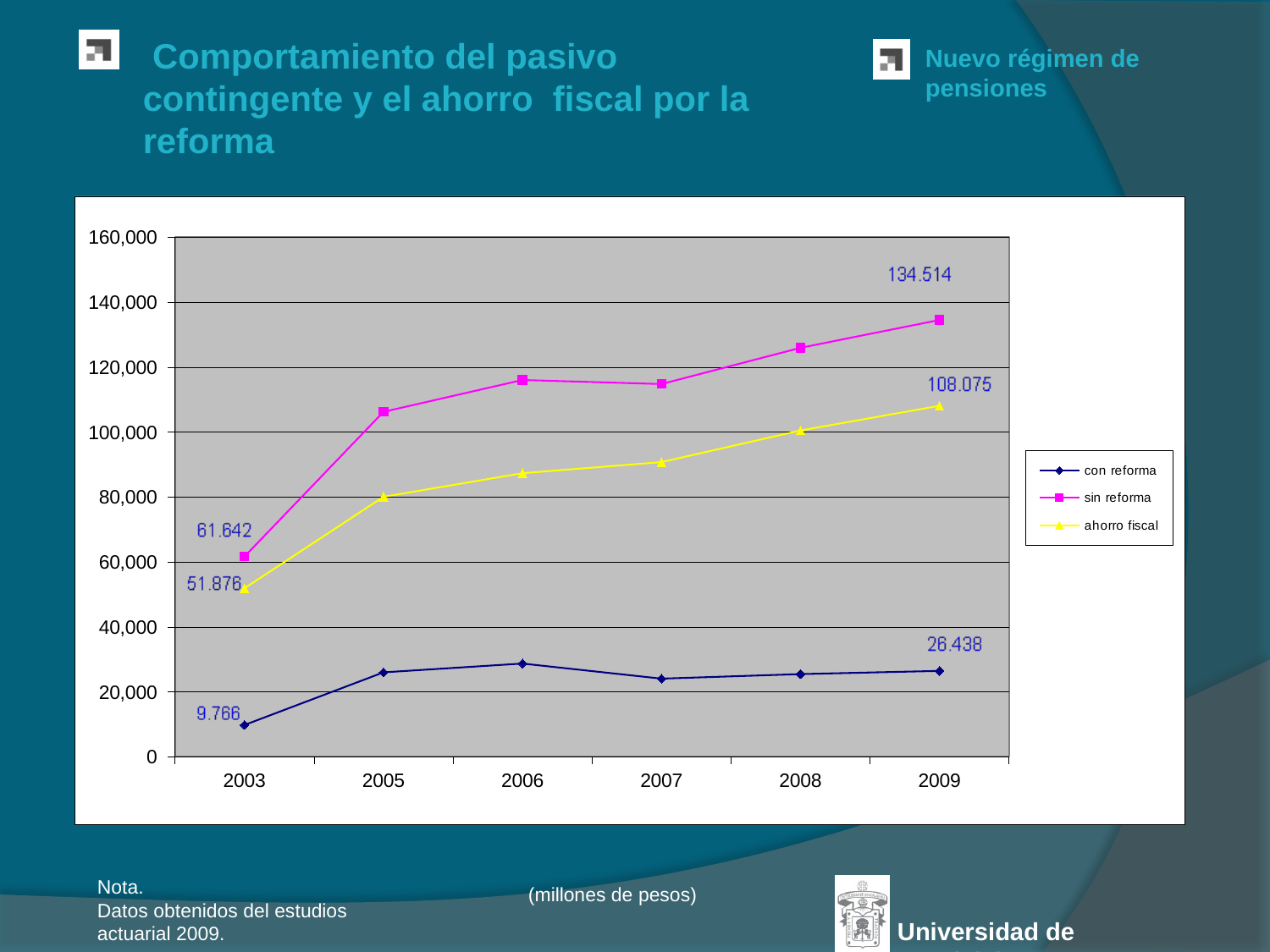
How many years are shown on the x axis? 6 What is the value for sin reforma in 2003? 61.642 What is the value for con reforma in 2003? 9.766 In which year is the con reforma series at its lowest value? 2003 What is the value for sin reforma in 2009? 134.514 In which year does the sin reforma series reach its highest value? 2009 What is the difference between the sin reforma value in 2009 and in 2003? 72.872 What is the value for ahorro fiscal in 2009? 108.075 Which is larger in 2009, the value for ahorro fiscal or the value for con reforma? ahorro fiscal How many series does the legend list? 3 What kind of chart is shown on the slide? line chart Is the value for sin reforma in 2005 greater or less than 100,000? greater